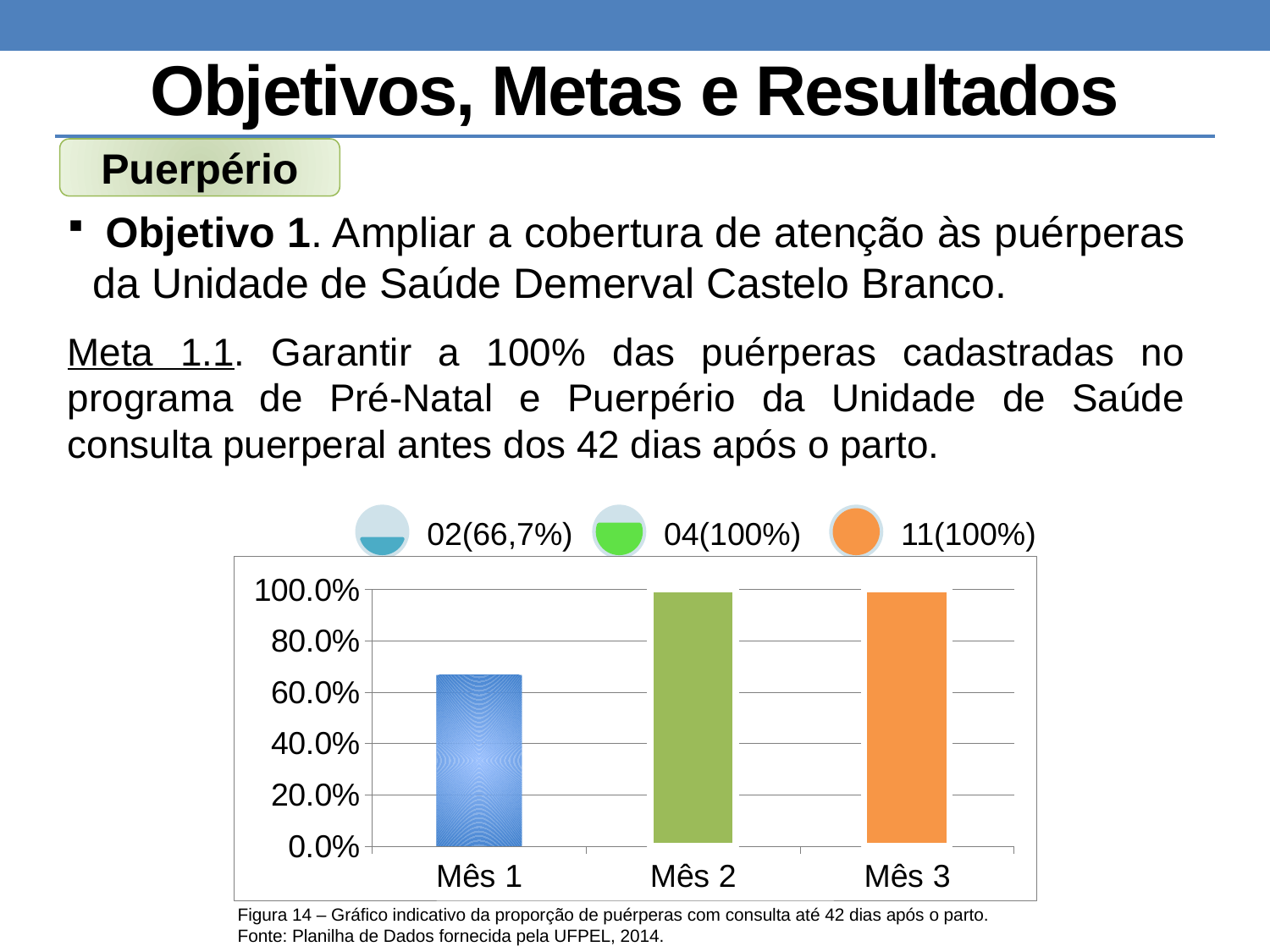
What is the value for Mês 2? 100.0% Do the values rise or fall from Mês 1 to Mês 2? rise What is the value for Mês 3? 100.0% Is the value for Mês 1 greater or less than 60.0%? greater Is the value for Mês 1 greater or less than 80.0%? less Which category has the lowest value? Mês 1 Which is larger, the value for Mês 1 or the value for Mês 2? Mês 2 What is the highest value shown on the y axis? 100.0% What kind of chart is shown on the slide? bar chart What colour is the bar for Mês 3? orange How many bars (categories) does the chart show? 3